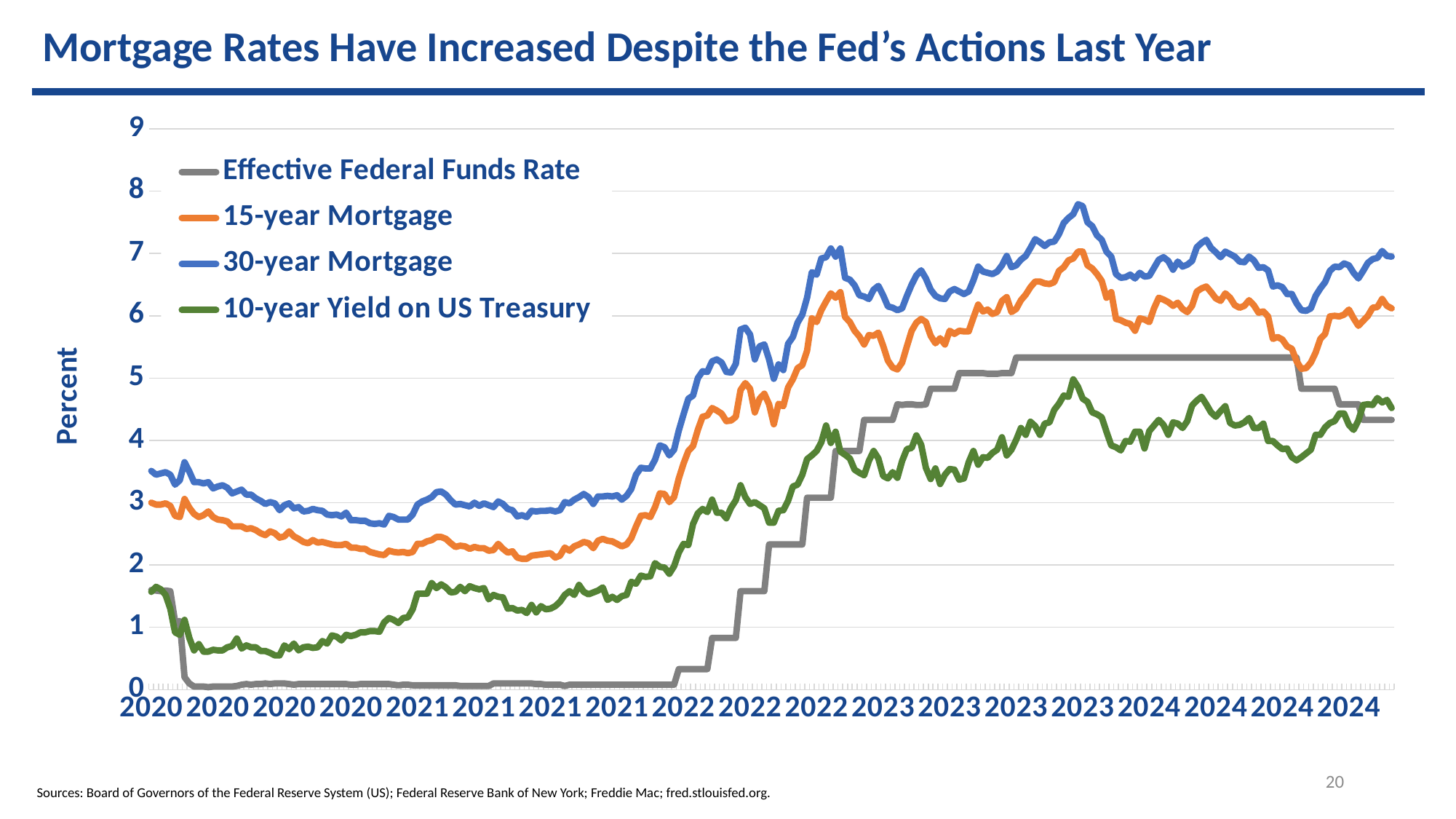
What kind of chart is shown on the slide? Line chart At the end of 2024, which is higher: the 15-year Mortgage rate or the 10-year Yield on US Treasury? 15-year Mortgage Did the Effective Federal Funds Rate rise or fall from early 2022 to mid-2023? Rise What is the label on the vertical axis? Percent Is the 30-year Mortgage rate at its 2023 peak greater or less than 7? greater What is the title of the slide's chart? Mortgage Rates Have Increased Despite the Fed's Actions Last Year Is the 15-year Mortgage rate at its 2023 peak greater or less than 6? greater Which series has the highest value at the end of 2024? 30-year Mortgage Is the Effective Federal Funds Rate during 2021 greater or less than 1? less How many series does the legend list? 4 Which series has the lowest value throughout 2021? Effective Federal Funds Rate